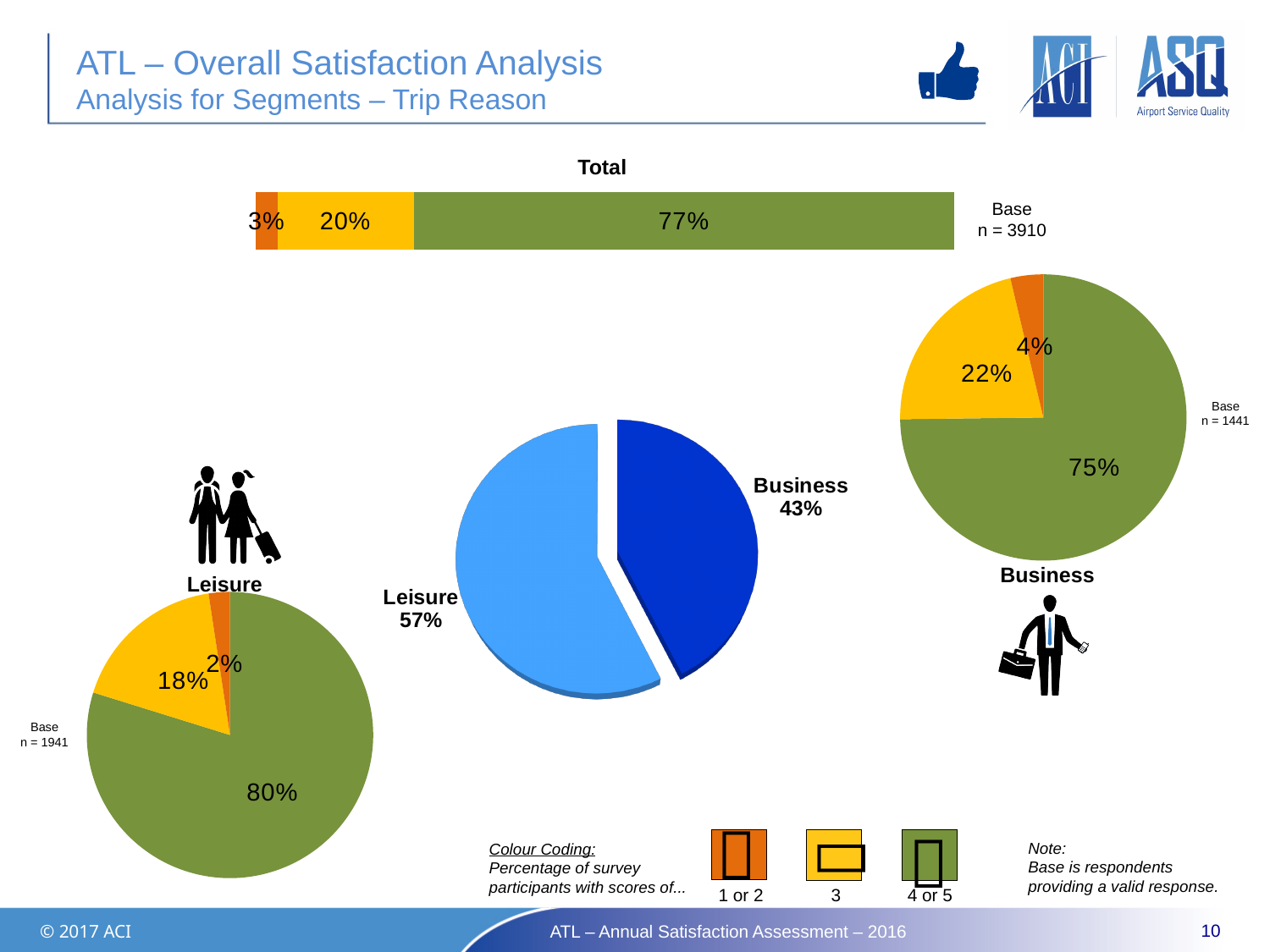
What type of chart is used to show the Total results at the top of the slide? Stacked bar chart In the Leisure pie chart on the left, what percentage gave scores of 4 or 5? 80% In the Leisure pie chart on the left, what percentage gave a score of 3? 18% In the central pie chart splitting trip reason, what share is Business? 43% In the Business pie chart on the right, what percentage gave scores of 1 or 2? 4% In the Total stacked bar at the top, what percentage of participants gave scores of 4 or 5? 77% What is the difference between the 4 or 5 share in the Leisure pie chart and the 4 or 5 share in the Business pie chart? 5% In the Business pie chart on the right, what percentage gave scores of 4 or 5? 75% In the Total stacked bar at the top, what percentage of participants gave scores of 1 or 2? 3% In the central pie chart splitting trip reason, which segment is larger, Leisure or Business? Leisure According to the colour coding legend, which score range does the green colour represent? 4 or 5 In the Total stacked bar at the top, what percentage of participants gave a score of 3? 20%